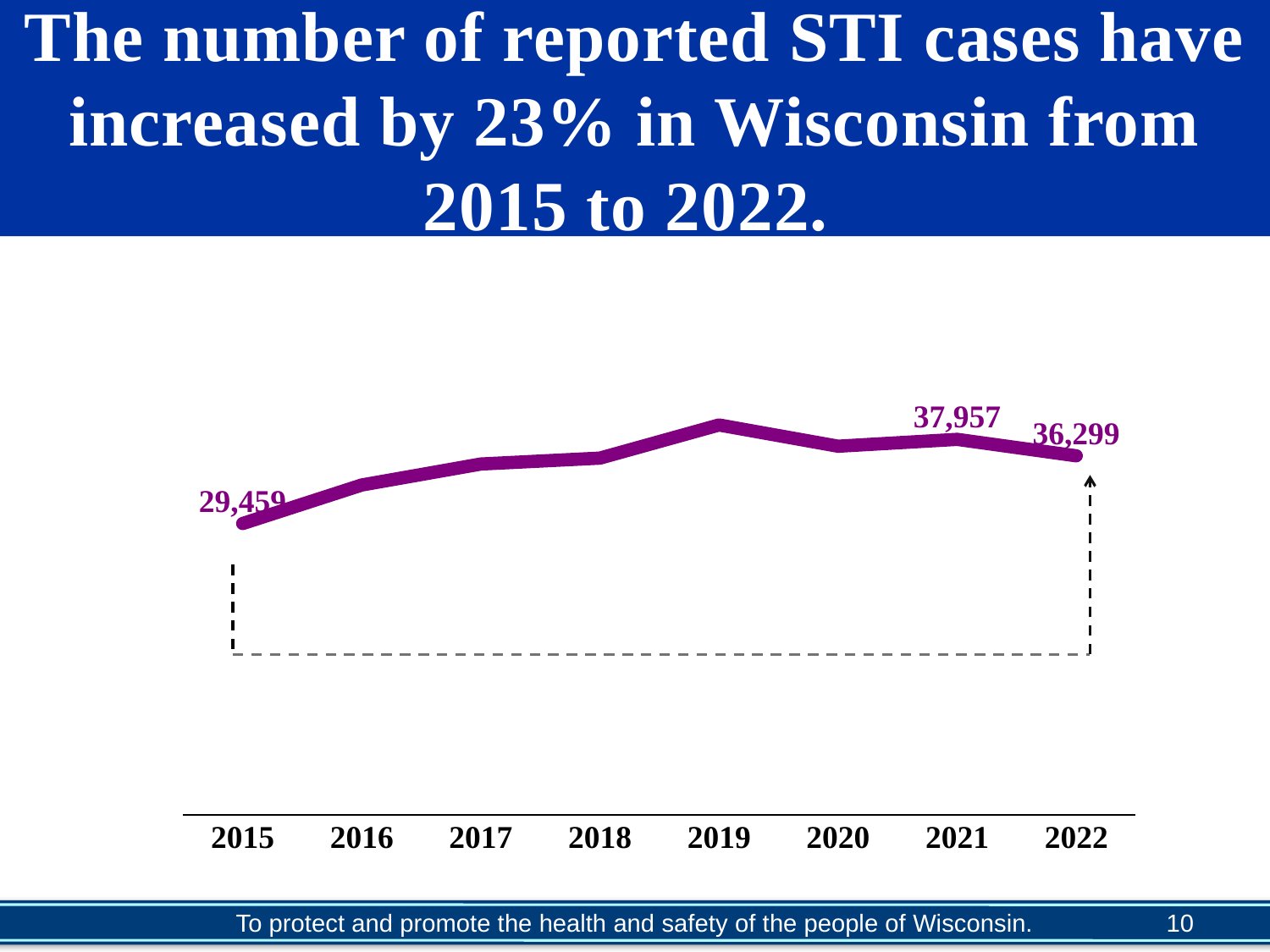
What is the number of reported STI cases in 2022? 36,299 What is the difference between the number of reported STI cases in 2021 and 2022? 1,658 What is the number of reported STI cases in 2015? 29,459 Which year had more reported STI cases, 2021 or 2022? 2021 By how much did the number of reported STI cases increase from 2015 to 2022? 6,840 Do the reported STI cases rise or fall from 2015 to 2019? Rise Which year had more reported STI cases, 2015 or 2022? 2022 What is the number of reported STI cases in 2021? 37,957 How many years are shown on the x axis of the chart? 8 What kind of chart is shown on the slide? Line chart Which year has the lowest number of reported STI cases? 2015 Which year has the highest number of reported STI cases? 2019